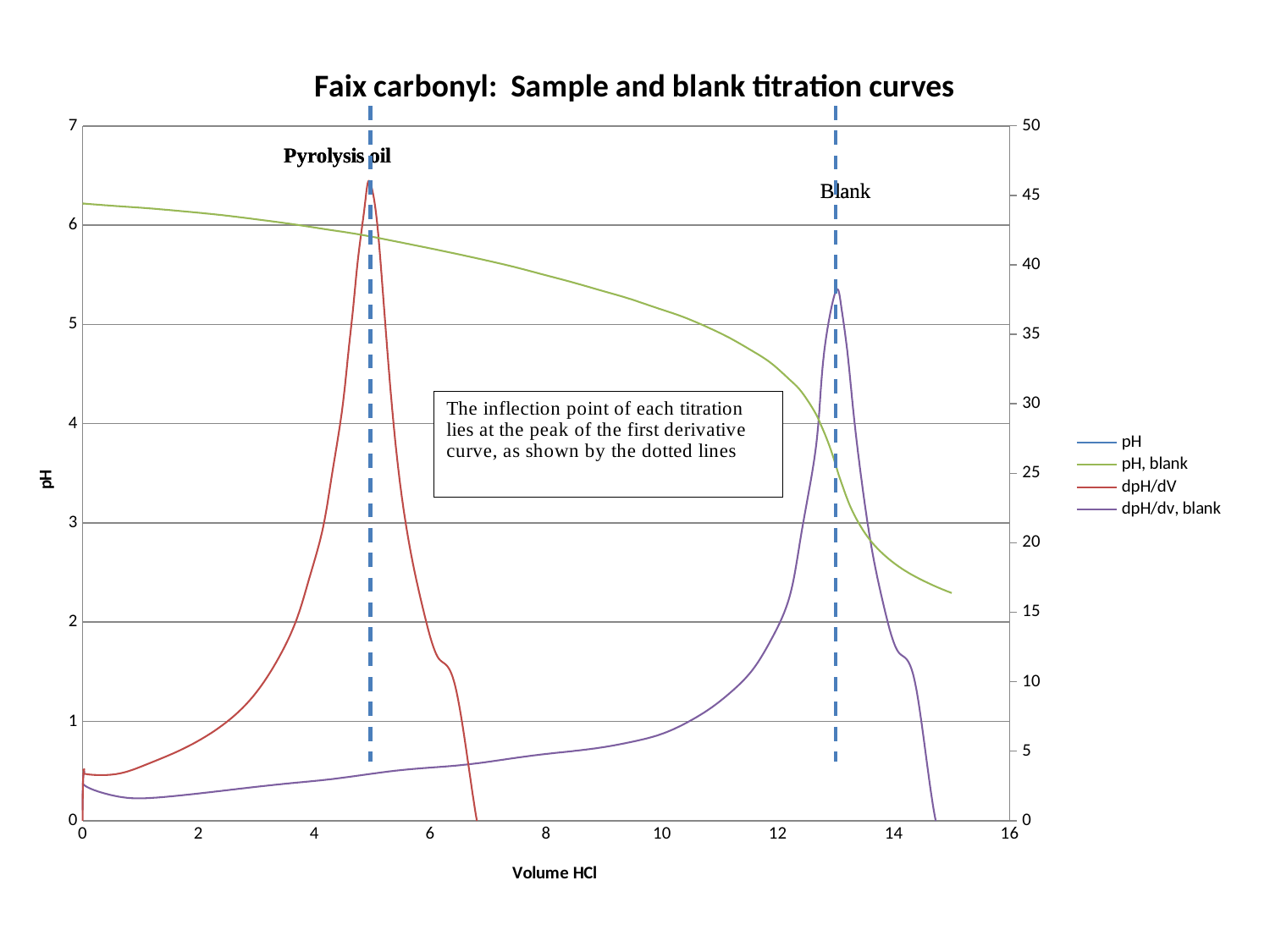
How many series does the legend list? 4 Is the pH, blank value at Volume HCl 0 greater or less than 6? greater Is the peak value of the dpH/dv, blank curve on the right axis greater or less than 35? greater What is the label of the x axis? Volume HCl What is the title of the chart? Faix carbonyl: Sample and blank titration curves Is the Volume HCl at the Pyrolysis oil inflection point (dotted line) greater or less than 6? less Which curve reaches a higher peak, dpH/dV or dpH/dv, blank? dpH/dV What kind of chart is shown on the slide? line chart Does the pH, blank curve rise or fall as Volume HCl increases? fall